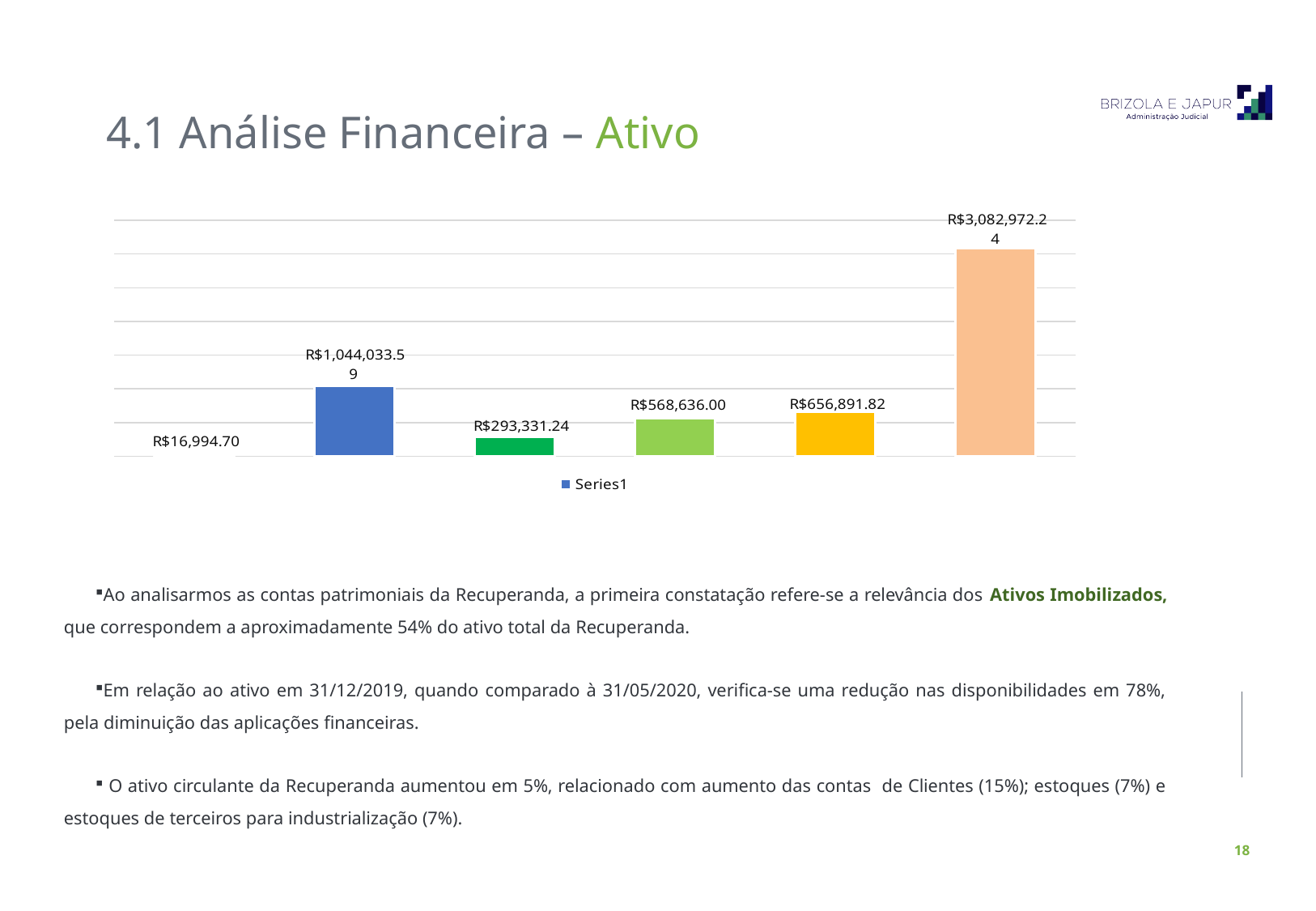
What is the value labelled on the dark green bar (third from the left)? R$293,331.24 What is the name of the series shown in the chart legend? Series1 How many bars are plotted in the chart? 6 What is the value labelled on the yellow bar (fifth from the left)? R$656,891.82 Which is larger: the value of the light green bar (fourth from the left) or the yellow bar (fifth from the left)? The yellow bar (R$656,891.82) What is the value labelled on the tallest (orange, rightmost) bar in the chart? R$3,082,972.24 How many series does the chart legend list? 1 What type of chart is shown on the slide? bar chart What is the difference between the value of the yellow bar (R$656,891.82) and the light green bar (R$568,636.00)? R$88,255.82 Which bar has the lowest value in the chart, and what is its value? The leftmost bar, R$16,994.70 What is the value labelled on the first (leftmost) bar in the chart? R$16,994.70 What is the value labelled on the blue bar (second from the left)? R$1,044,033.59